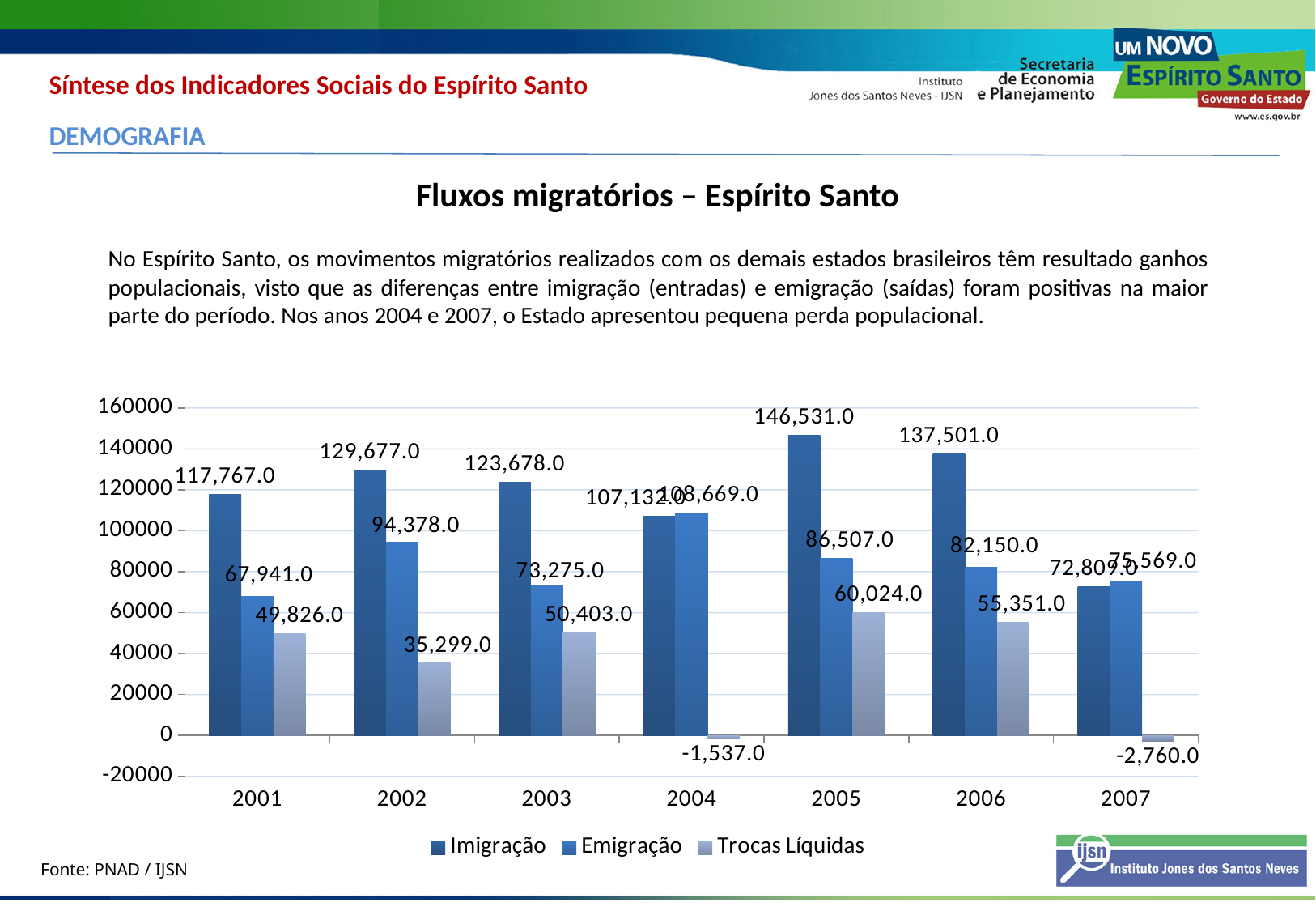
How many series does the legend list? 3 What is the value of Emigração in 2006? 82,150.0 In 2007, which is larger: Imigração or Emigração? Emigração What is the value of Trocas Líquidas in 2004? -1,537.0 How many years are shown on the x axis? 7 Is the value of Emigração in 2002 greater or less than 100000? less In which year is Trocas Líquidas lowest? 2007 What is the difference between Imigração and Emigração in 2002? 35,299.0 What is the value of Imigração in 2005? 146,531.0 In which year is Imigração highest? 2005 What kind of chart is shown on the slide? bar chart In which year is Emigração highest? 2004